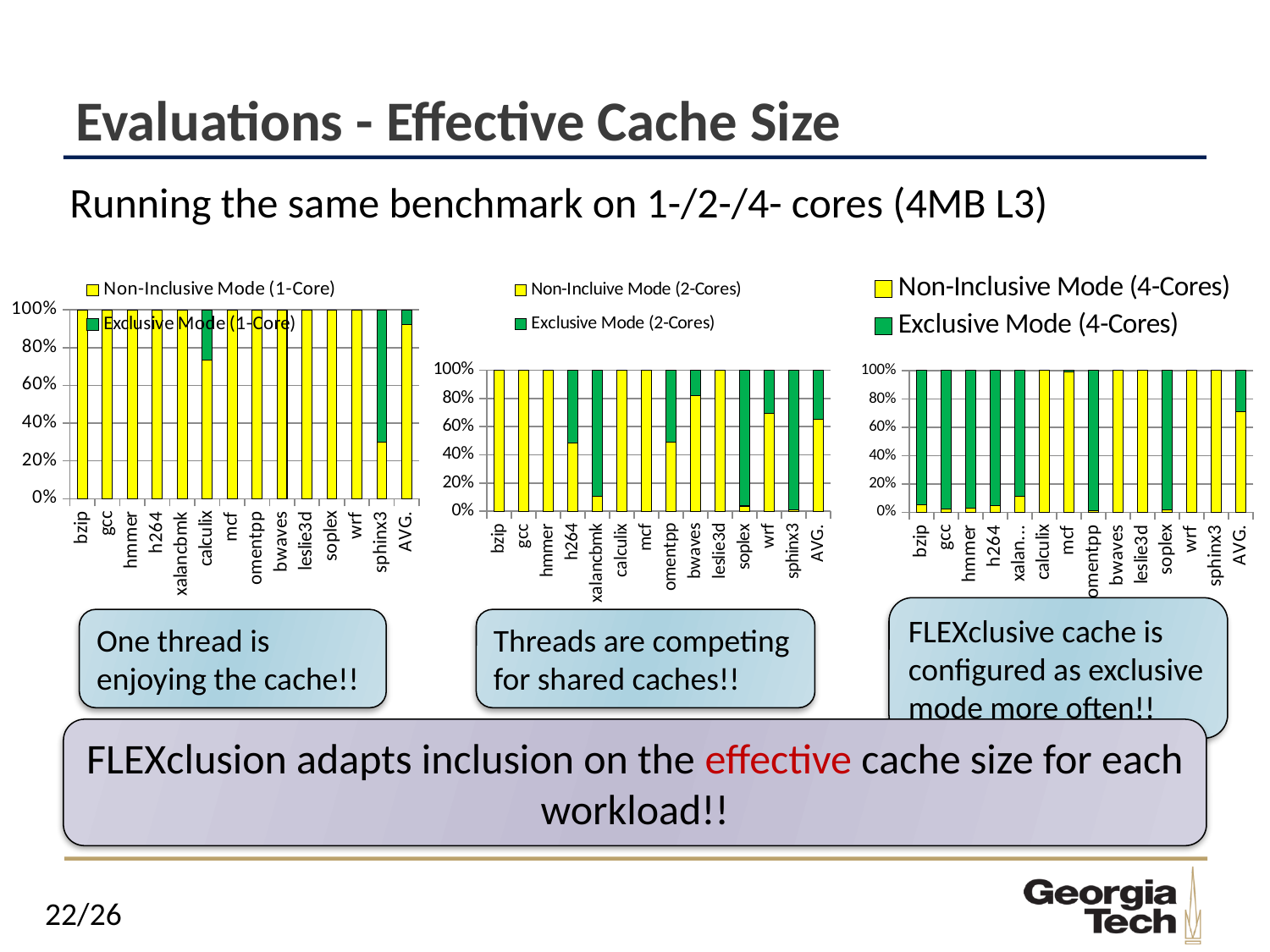
In the left chart (1-Core), is the Non-Inclusive Mode value for calculix greater or less than 60%? greater What kind of chart is the left chart (1-Core)? Stacked bar chart How many series does the legend of the right chart (4-Cores) list? 2 In the right chart (4-Cores), is the Non-Inclusive Mode value for AVG. greater or less than 60%? greater In the left chart (1-Core), is the Non-Inclusive Mode value for sphinx3 greater or less than 40%? less How many benchmark categories are shown on the x axis of the middle chart (2-Cores)? 14 In the middle chart (2-Cores), which has the larger Non-Inclusive Mode share, wrf or h264? wrf In the left chart (1-Core), which category has the lowest Non-Inclusive Mode share? sphinx3 What is the name of the second legend entry in the middle chart (2-Cores)? Exclusive Mode (2-Cores) In the middle chart (2-Cores), which category has the lowest Non-Inclusive Mode share? sphinx3